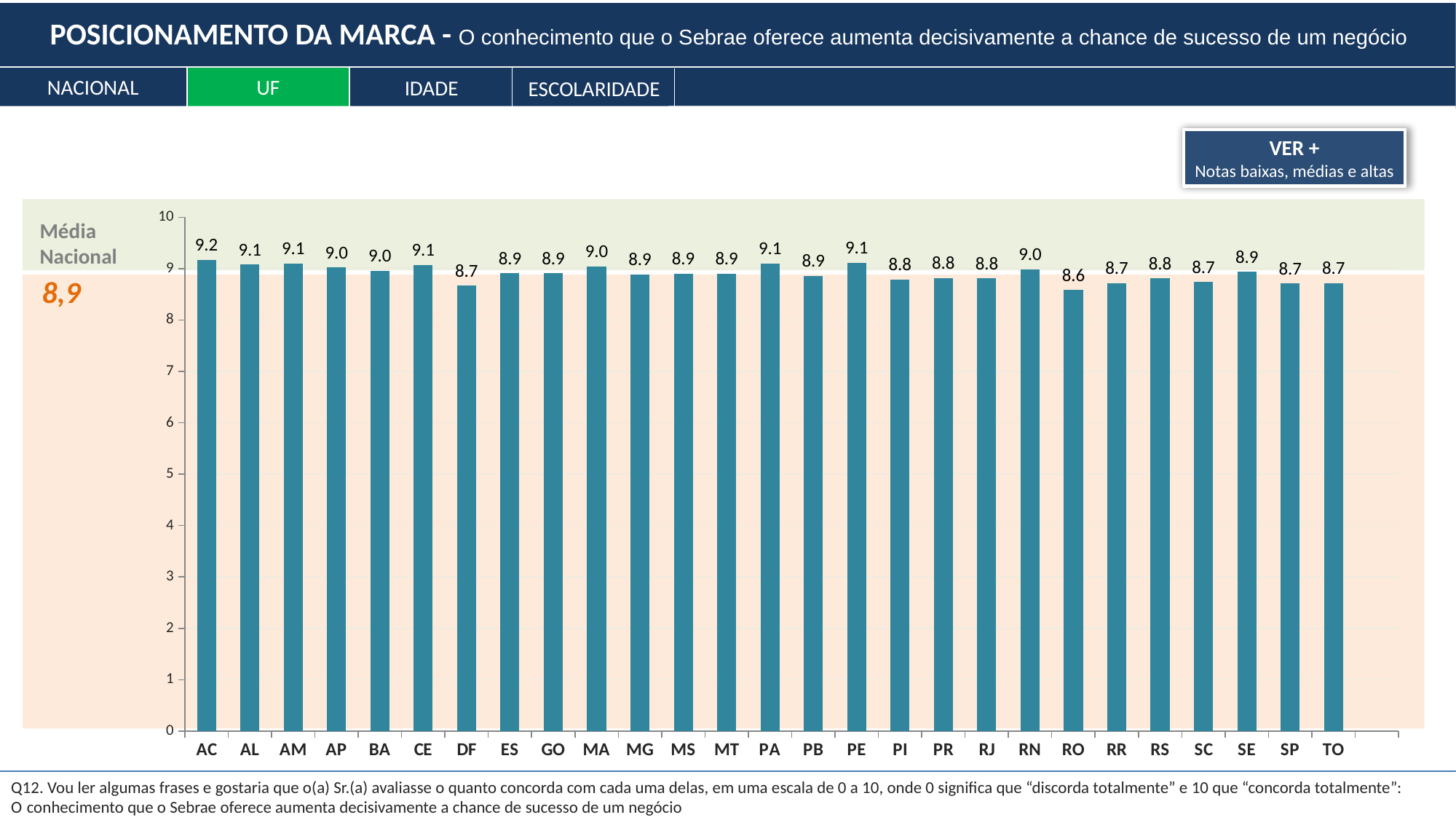
What is the value for PE? 9.1 What kind of chart is shown on the slide? Bar chart How many states are shown on the x axis? 27 Is the value for PI greater or less than 9? less What is the value for RO? 8.6 Which is larger, the value for DF or the value for MA? MA What is the value of the Média Nacional shown on the chart? 8,9 What is the value for SP? 8.7 Which state has the highest value? AC What is the difference between the values for AC and RO? 0.6 What is the value for AC? 9.2 Which state has the lowest value? RO